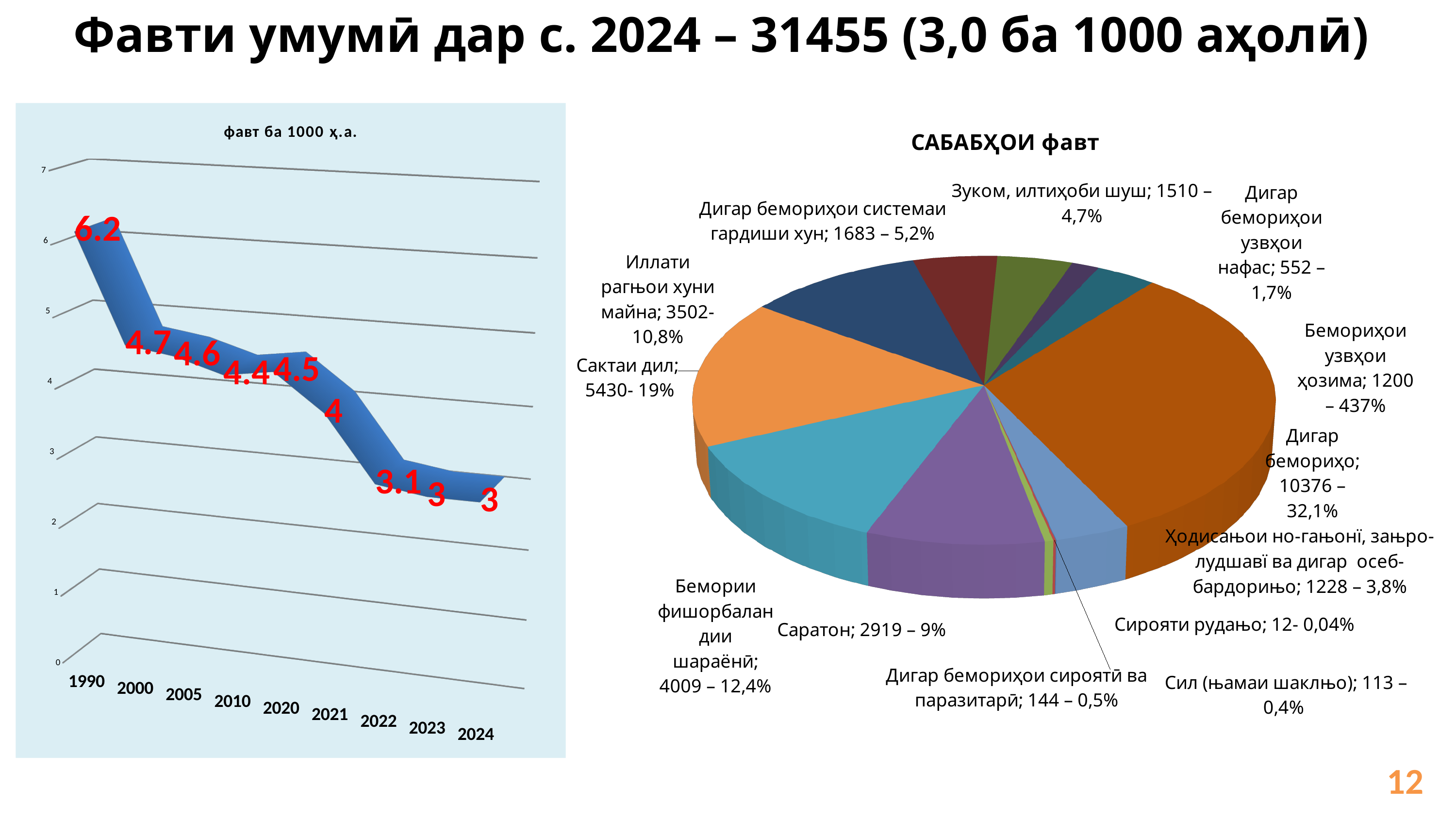
In the pie chart "САБАБҲОИ фавт", what share does Сактаи дил have? 19% In the left chart "фавт ба 1000 ҳ.а.", which year has the highest value? 1990 In the left chart "фавт ба 1000 ҳ.а.", what is the value for 1990? 6.2 What kind of chart is the right chart titled "САБАБҲОИ фавт"? pie chart In the left chart "фавт ба 1000 ҳ.а.", do the values generally rise or fall from 1990 to 2024? fall How many years are shown on the x axis of the left chart "фавт ба 1000 ҳ.а."? 9 In the pie chart "САБАБҲОИ фавт", what number is given for Саратон? 2919 In the left chart "фавт ба 1000 ҳ.а.", what is the value for 2024? 3 In the pie chart "САБАБҲОИ фавт", which is larger: Саратон or Сактаи дил? Сактаи дил In the left chart "фавт ба 1000 ҳ.а.", what is the difference between the values for 1990 and 2024? 3.2 In the pie chart "САБАБҲОИ фавт", which category has the largest slice? Дигар бемориҳо What kind of chart is the left chart titled "фавт ба 1000 ҳ.а."? line chart